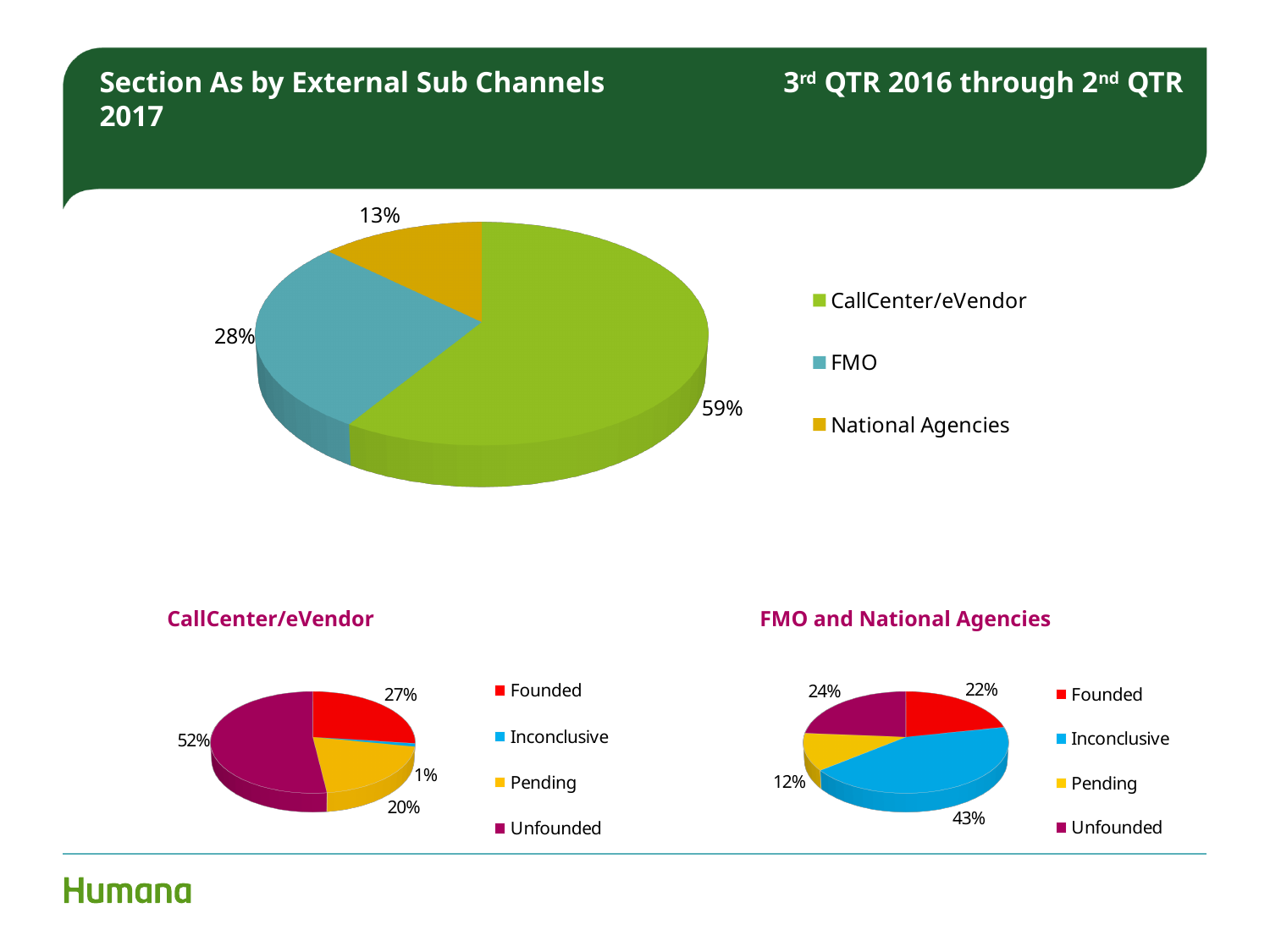
In the FMO and National Agencies pie chart, which is larger, Founded or Unfounded? Unfounded In the CallCenter/eVendor pie chart, which category has the smallest share? Inconclusive What kind of chart is the top chart on the slide? Pie chart In the top pie chart, what share does CallCenter/eVendor have? 59% In the top pie chart, what share does FMO have? 28% How many categories does the legend of the top pie chart list? 3 In the CallCenter/eVendor pie chart, what is the difference between Founded and Pending? 7% In the FMO and National Agencies pie chart, what share is Pending? 12% In the top pie chart, what is the difference between the FMO share and the National Agencies share? 15% In the FMO and National Agencies pie chart, which category has the largest share? Inconclusive In the top pie chart, which category has the smallest share? National Agencies In the CallCenter/eVendor pie chart, what share is Unfounded? 52%